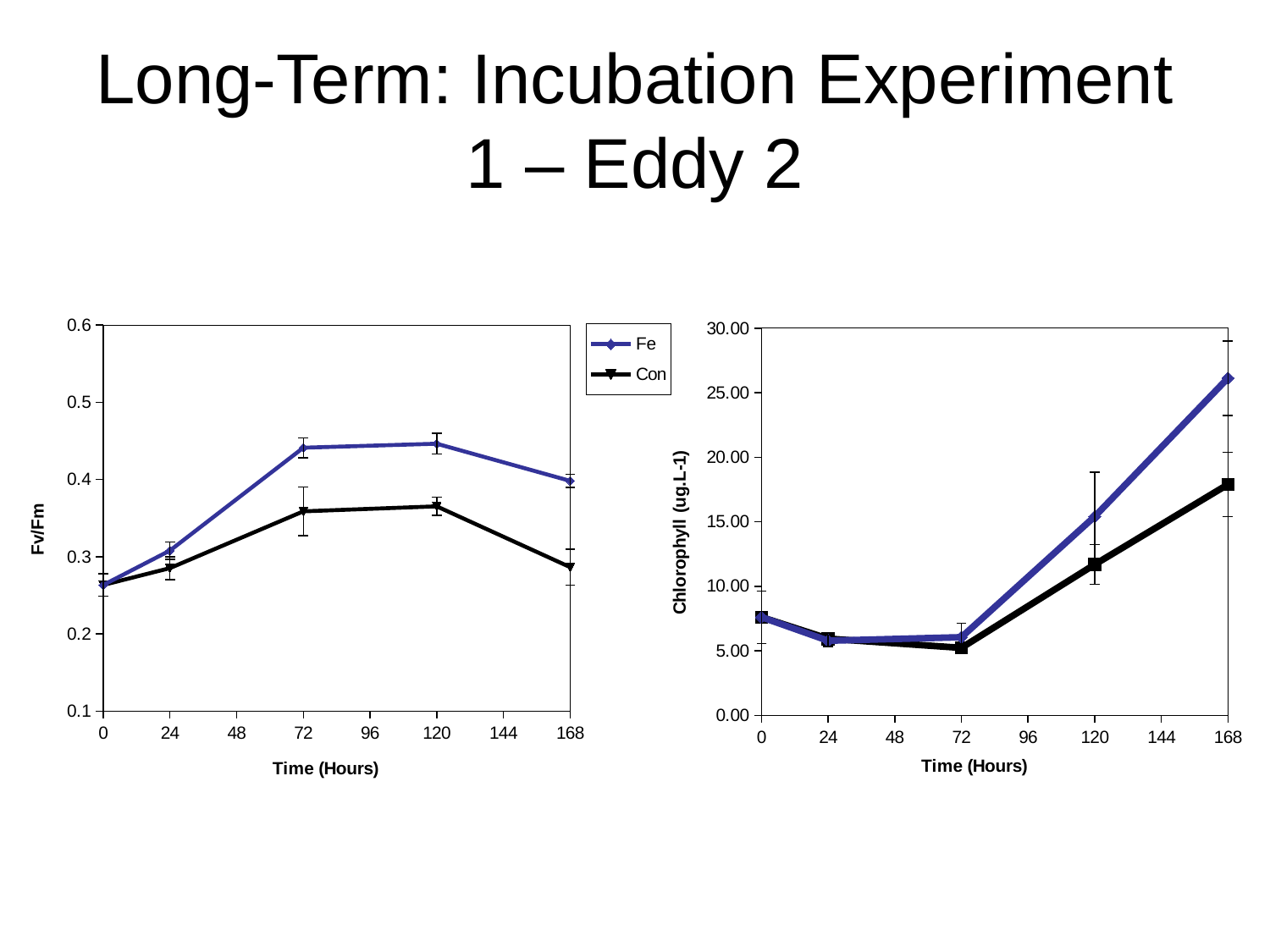
In the left chart (Fv/Fm), which series has the higher value at 72 hours, Fe or Con? Fe What kind of chart is the left chart (Fv/Fm)? line chart In the left chart (Fv/Fm), is the Con value at 72 hours greater or less than 0.3? greater In the left chart (Fv/Fm), is the Fe value at 120 hours greater or less than 0.4? greater In the right chart (Chlorophyll), is the blue line's value at 168 hours greater or less than 20.00? greater In the right chart (Chlorophyll), do the values rise or fall between 72 and 168 hours? rise How many series does the legend of the left chart (Fv/Fm) list? 2 What are the two series named in the legend of the left chart (Fv/Fm)? Fe and Con What is the y-axis label of the right chart? Chlorophyll (ug.L-1) How many time points are plotted for each series in the left chart (Fv/Fm)? 5